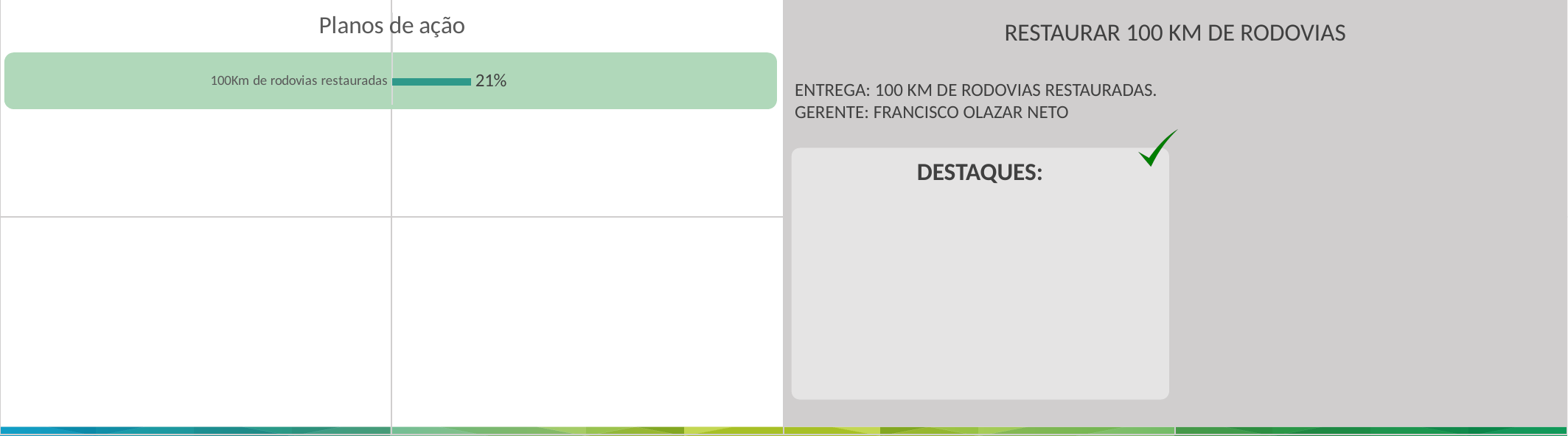
What kind of chart is the "Planos de ação" chart? bar chart How many categories are plotted in the "Planos de ação" chart? 1 What is the value shown for "100Km de rodovias restauradas" in the "Planos de ação" chart? 21% In the "Planos de ação" chart, is the value for "100Km de rodovias restauradas" greater or less than 50%? less What is the title of the chart on the left side of the slide? Planos de ação What is the label of the only category in the "Planos de ação" chart? 100Km de rodovias restauradas